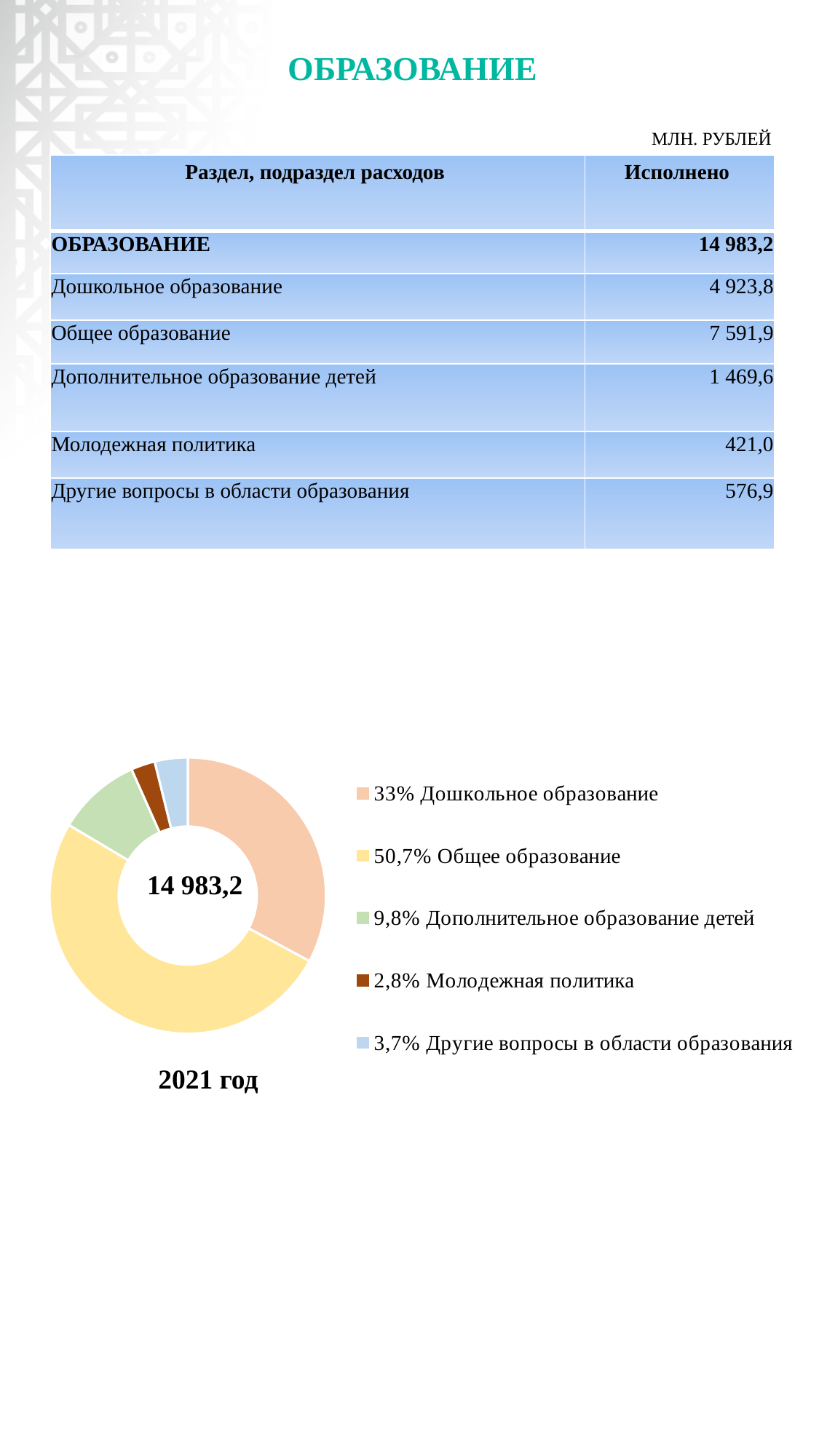
What kind of chart is shown on the slide? doughnut chart Which category has the smallest slice in the doughnut chart? Молодежная политика In the doughnut chart, which slice is larger: Дополнительное образование детей or Другие вопросы в области образования? Дополнительное образование детей Which year is labelled under the doughnut chart? 2021 год What share of the doughnut chart does Молодежная политика have? 2,8% What share of the doughnut chart does Общее образование have? 50,7% What share of the doughnut chart does Другие вопросы в области образования have? 3,7% What total value is printed in the centre of the doughnut chart? 14 983,2 Which category has the largest slice in the doughnut chart? Общее образование How many categories does the doughnut chart's legend list? 5